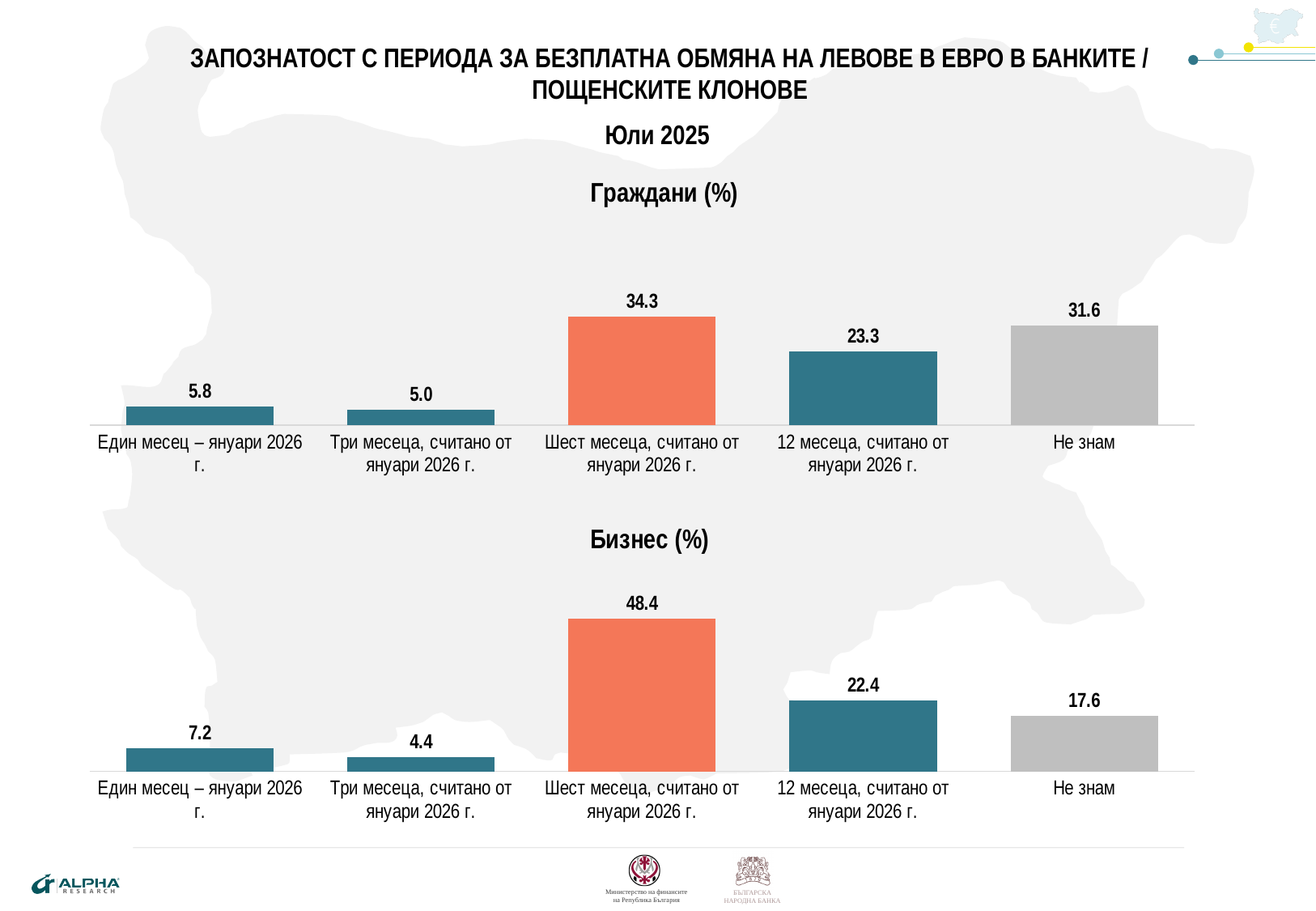
In the Граждани (%) chart, which category has the highest value? Шест месеца, считано от януари 2026 г. In the Граждани (%) chart, which is larger: 12 месеца, считано от януари 2026 г. or Не знам? Не знам In the Граждани (%) chart, what is the difference between Шест месеца, считано от януари 2026 г. and Не знам? 2.7 In the Бизнес (%) chart, what is the value for Не знам? 17.6 In the Бизнес (%) chart, which category has the lowest value? Три месеца, считано от януари 2026 г. In the Бизнес (%) chart, what is the value for Един месец – януари 2026 г.? 7.2 In the Граждани (%) chart, which category has the lowest value? Три месеца, считано от януари 2026 г. In the Граждани (%) chart, what is the value for Шест месеца, считано от януари 2026 г.? 34.3 In the Бизнес (%) chart, what is the difference between Шест месеца, считано от януари 2026 г. and 12 месеца, считано от януари 2026 г.? 26.0 How many categories does the Бизнес (%) chart show? 5 In the Бизнес (%) chart, which is larger: 12 месеца, считано от януари 2026 г. or Не знам? 12 месеца, считано от януари 2026 г. What kind of chart is the Граждани (%) chart? Bar chart